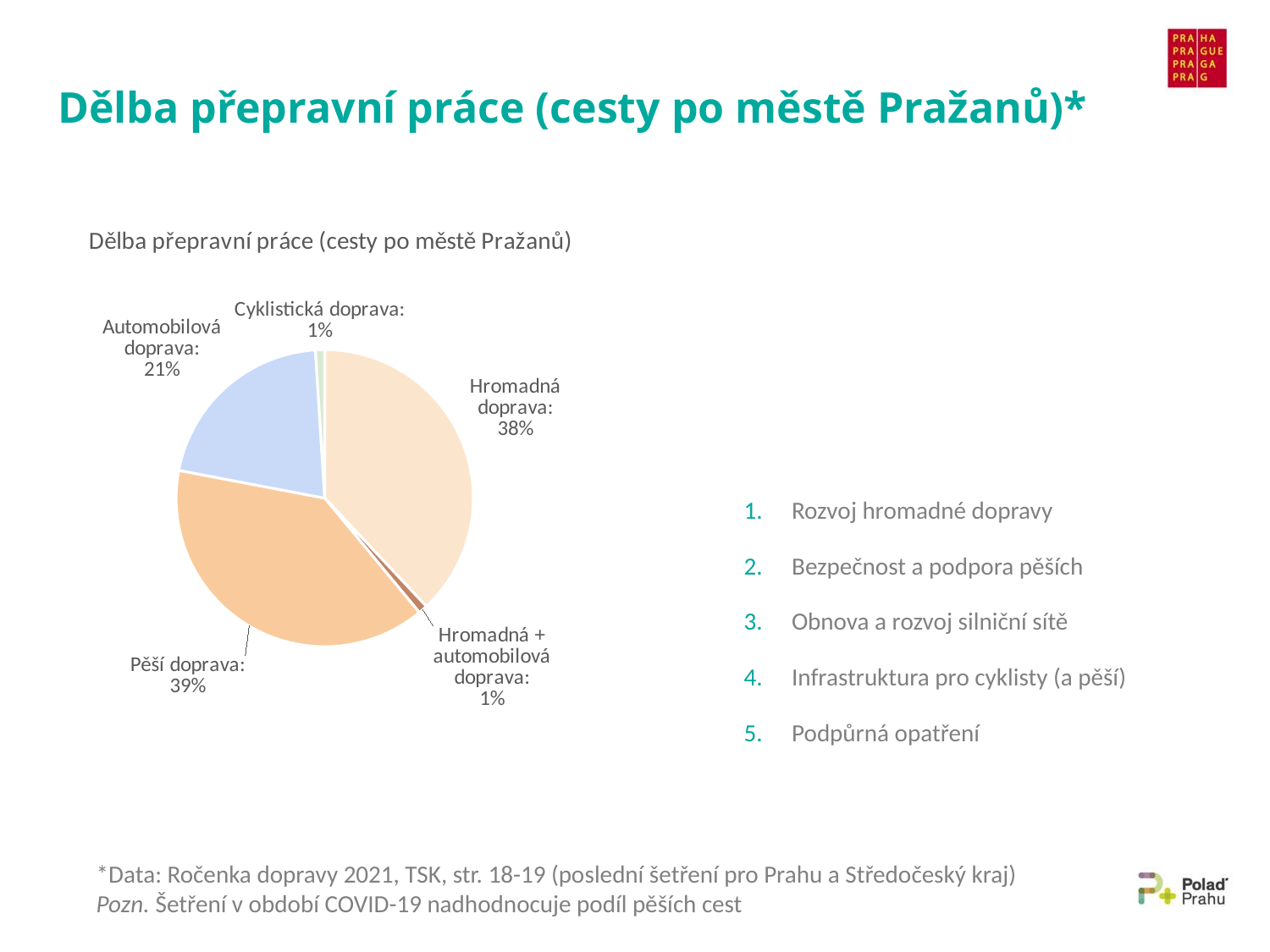
What is the value shown for Pěší doprava? 39% What is the title of the pie chart? Dělba přepravní práce (cesty po městě Pražanů) What is the difference in percentage points between Pěší doprava and Automobilová doprava? 18 percentage points What kind of chart is shown on the slide? pie chart How many categories (slices) does the pie chart have? 5 What is the difference in percentage points between Hromadná doprava and Automobilová doprava? 17 percentage points What is the value shown for Hromadná + automobilová doprava? 1% What is the value shown for Automobilová doprava? 21% What is the value shown for Cyklistická doprava? 1% Which category has the largest share of the pie? Pěší doprava Which is larger, the share for Hromadná doprava or the share for Automobilová doprava? Hromadná doprava What share of the pie does Hromadná doprava represent? 38%